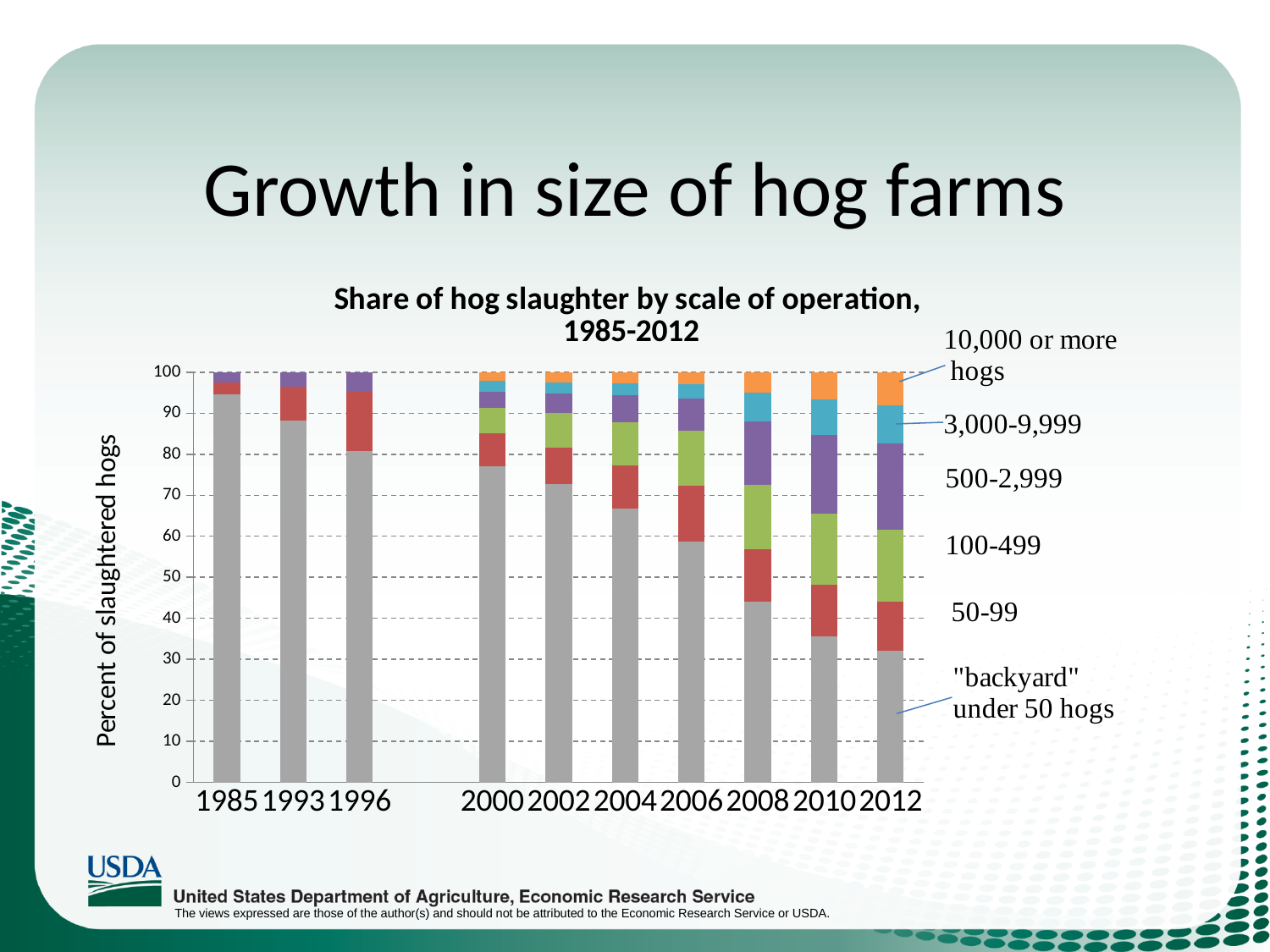
Is the "backyard" under 50 hogs share in 2012 greater or less than 40? less What kind of chart is shown on the slide? Stacked bar chart Is the "backyard" under 50 hogs share in 2008 greater or less than 50? less Does the share of slaughter from "backyard" operations under 50 hogs rise or fall from 1985 to 2012? fall How many scale-of-operation categories are labelled on the chart? 6 Is the "backyard" under 50 hogs share in 2004 greater or less than 60? greater In which year is the "backyard" under 50 hogs share the lowest? 2012 How many years (bars) are plotted on the x axis? 10 In which year is the "backyard" under 50 hogs share the highest? 1985 What is the label on the vertical axis? Percent of slaughtered hogs What is the title of the chart? Share of hog slaughter by scale of operation, 1985-2012